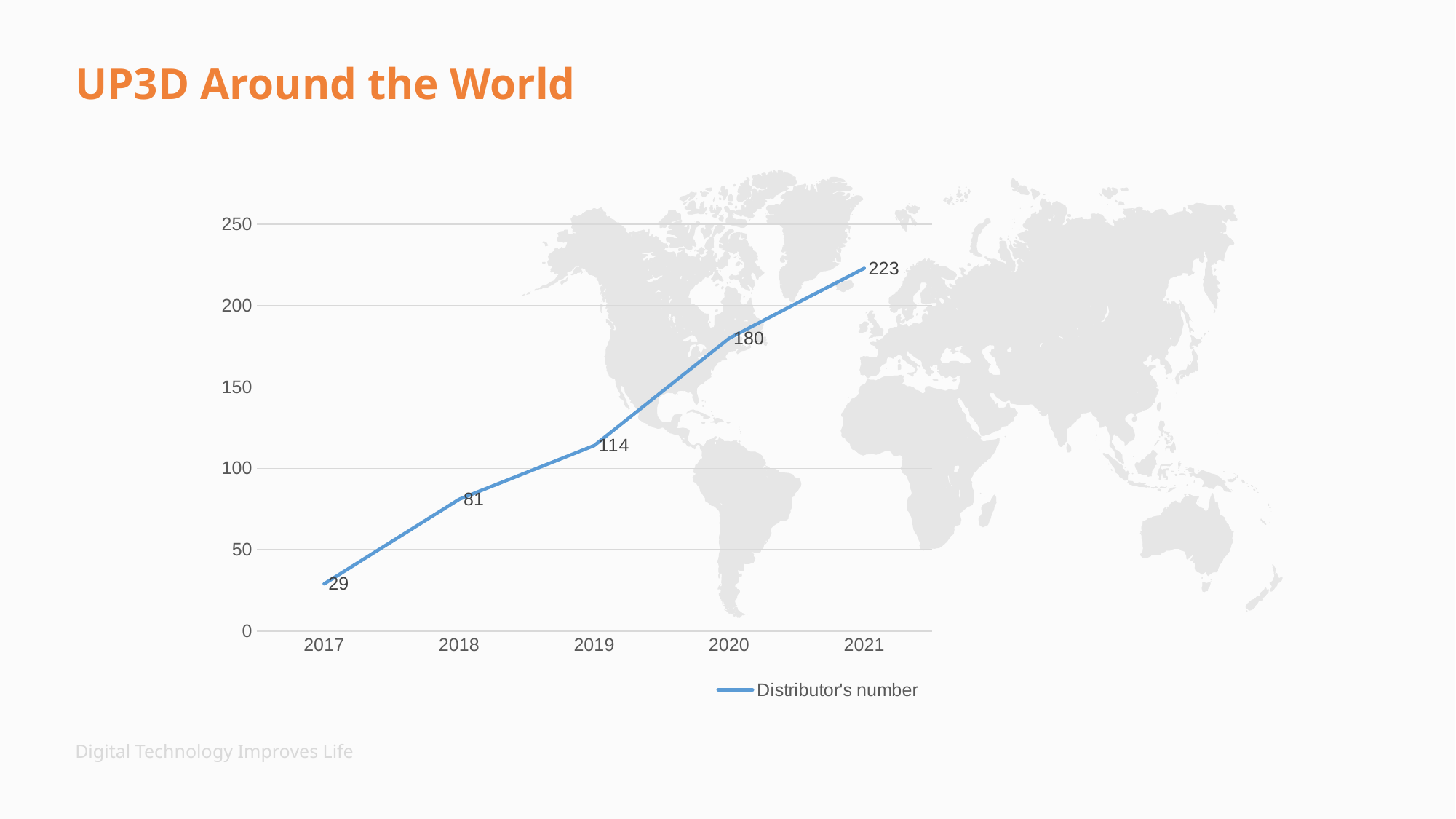
How many series does the legend list? 1 Which year has the highest distributor's number? 2021 Does the distributor's number rise or fall from 2017 to 2021? Rise How many years are shown on the x axis of the chart? 5 What is the difference between the distributor's number in 2020 and in 2018? 99 What is the distributor's number for 2019? 114 What kind of chart is shown on the slide? Line chart Which year has the lowest distributor's number? 2017 By how much did the distributor's number increase from 2017 to 2021? 194 Which year has a larger distributor's number, 2018 or 2020? 2020 What is the distributor's number for 2017? 29 What is the distributor's number for 2021? 223